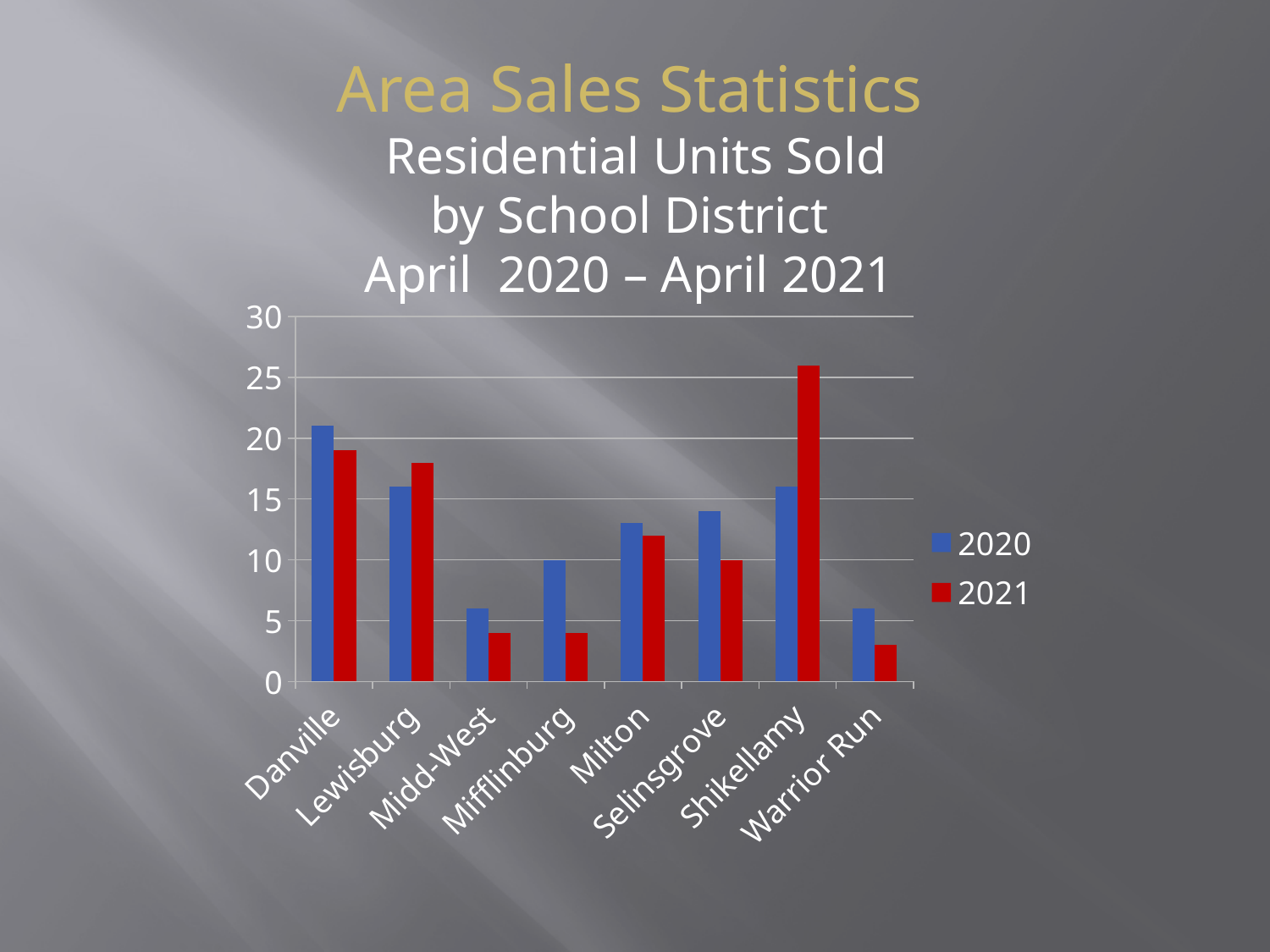
Is the 2020 value for Danville greater or less than 20? greater How many school districts are shown on the x axis of the chart? 8 Which school district has the highest value for 2020? Danville Is the 2021 value for Lewisburg greater or less than 20? less Which school district has the highest value for 2021? Shikellamy For Danville, which year has the larger value, 2020 or 2021? 2020 What kind of chart is shown on the slide? bar chart Which colour represents the 2021 series in the chart? red Is the 2021 value for Shikellamy greater or less than 25? greater How many series does the chart's legend list? 2 For Shikellamy, which year has the larger value, 2020 or 2021? 2021